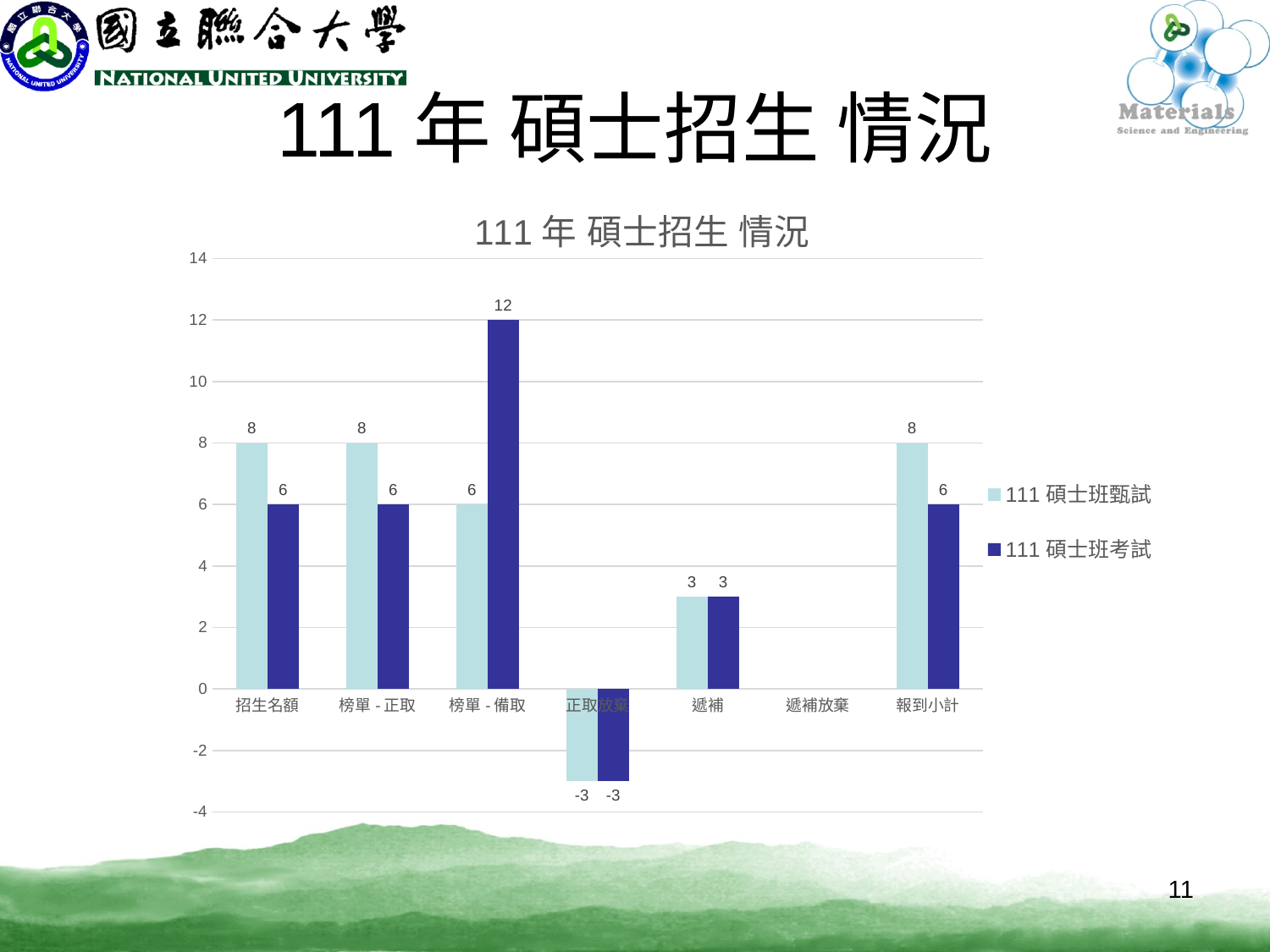
For 榜單 - 正取, which series has the larger value, 111 碩士班甄試 or 111 碩士班考試? 111 碩士班甄試 What is the value of 111 碩士班甄試 for 招生名額? 8 What is the value of 111 碩士班考試 for 報到小計? 6 How many categories are shown on the x axis? 7 How many series does the legend list? 2 What type of chart is shown on the slide? bar chart What is the value of 111 碩士班甄試 for 正取放棄? -3 What is the difference between the 111 碩士班考試 and 111 碩士班甄試 values for 榜單 - 備取? 6 What is the value of 111 碩士班甄試 for 遞補? 3 What is the value of 111 碩士班考試 for 榜單 - 備取? 12 Which category has the highest value for 111 碩士班考試? 榜單 - 備取 What is the title of the chart? 111 年 碩士招生 情況